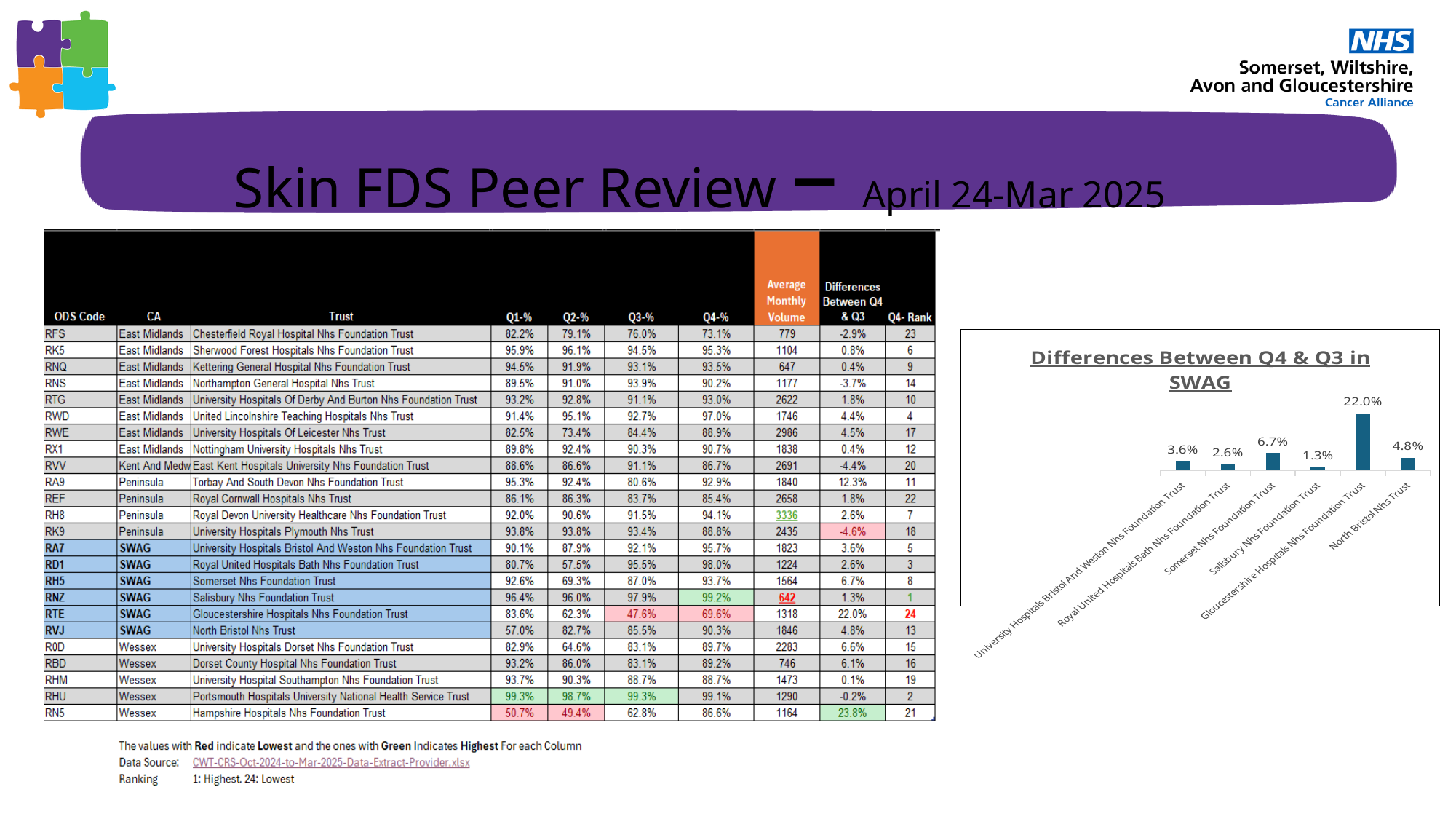
How many trusts are plotted in the chart? 6 What is the value for North Bristol Nhs Trust in the chart? 4.8% What is the value for Salisbury Nhs Foundation Trust in the chart? 1.3% What kind of chart is shown on the slide? Bar chart What is the difference between the values for Somerset Nhs Foundation Trust and Salisbury Nhs Foundation Trust in the chart? 5.4% Which has the larger value in the chart, University Hospitals Bristol And Weston Nhs Foundation Trust or Royal United Hospitals Bath Nhs Foundation Trust? University Hospitals Bristol And Weston Nhs Foundation Trust What is the value for Gloucestershire Hospitals Nhs Foundation Trust in the chart? 22.0% What is the value for Somerset Nhs Foundation Trust in the chart? 6.7% What is the title of the chart on the slide? Differences Between Q4 & Q3 in SWAG What is the difference between the values for Gloucestershire Hospitals Nhs Foundation Trust and North Bristol Nhs Trust in the chart? 17.2% Which trust has the highest value in the chart? Gloucestershire Hospitals Nhs Foundation Trust Which trust has the lowest value in the chart? Salisbury Nhs Foundation Trust